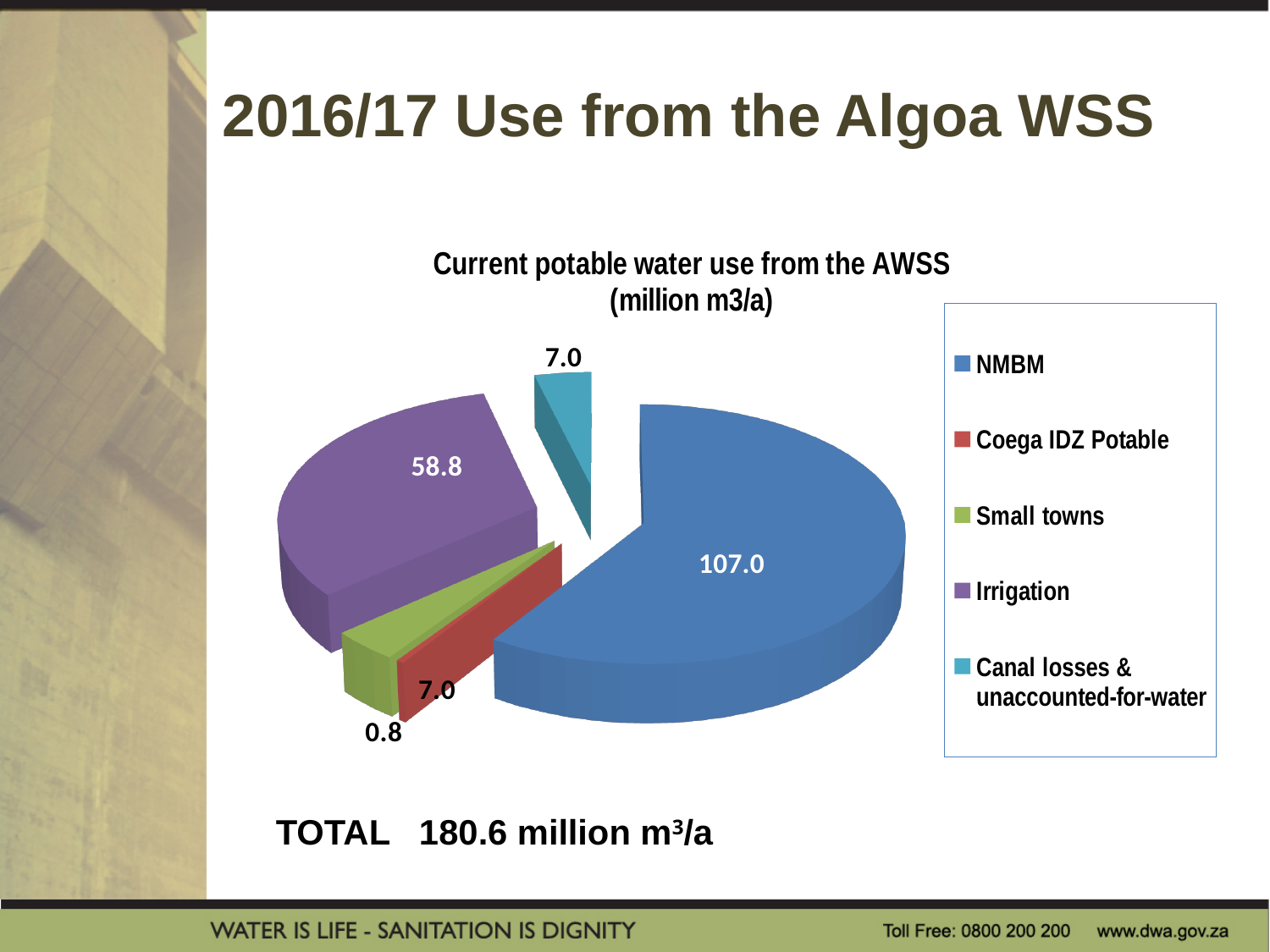
Which category has the smallest slice of the pie chart? Coega IDZ Potable How many categories are shown in the pie chart? 5 What is the title of the chart? Current potable water use from the AWSS (million m3/a) What is the difference between the Coega IDZ Potable value and the Small towns value? 6.2 What is the value for Irrigation in the pie chart? 58.8 What is the value for Small towns in the pie chart? 7.0 What kind of chart is shown on the slide? Pie chart What is the value for NMBM in the pie chart? 107.0 What is the difference between the NMBM value and the Irrigation value? 48.2 Which category has the largest slice of the pie chart? NMBM Which is larger, the value for Irrigation or the value for Canal losses & unaccounted-for-water? Irrigation What is the value for Coega IDZ Potable in the pie chart? 0.8